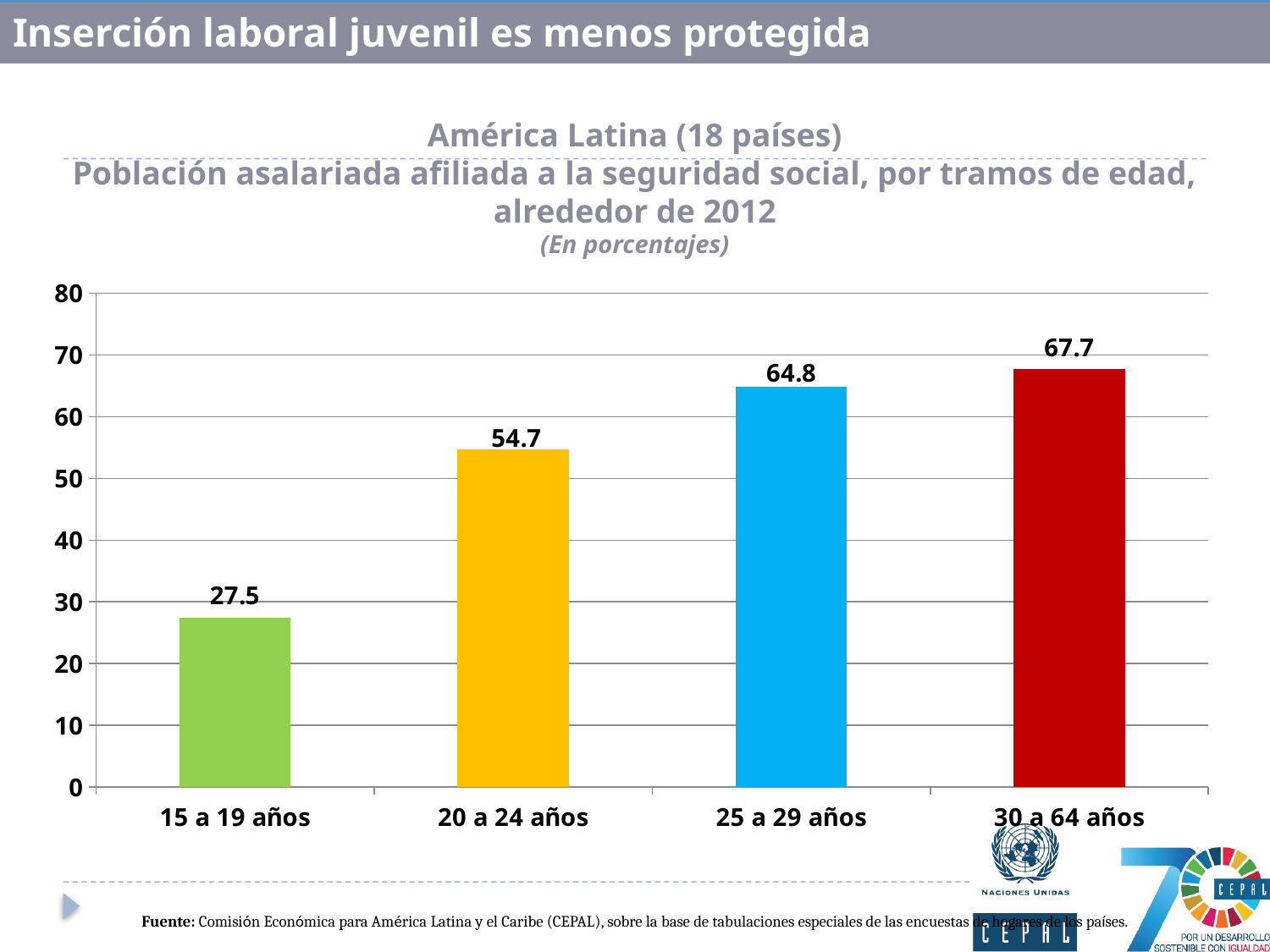
Which age group has the highest value? 30 a 64 años What is the value for the 15 a 19 años age group? 27.5 What is the value for the 20 a 24 años age group? 54.7 How many age groups are shown in the chart? 4 What colour is the bar for 30 a 64 años? Red Which age group has the lowest value? 15 a 19 años What is the difference between the values for 30 a 64 años and 15 a 19 años? 40.2 What is the value for the 30 a 64 años age group? 67.7 What kind of chart is shown on the slide? Bar chart Which is larger, the value for 20 a 24 años or the value for 25 a 29 años? 25 a 29 años What is the value for the 25 a 29 años age group? 64.8 Do the values rise or fall as the age groups get older along the x axis? Rise